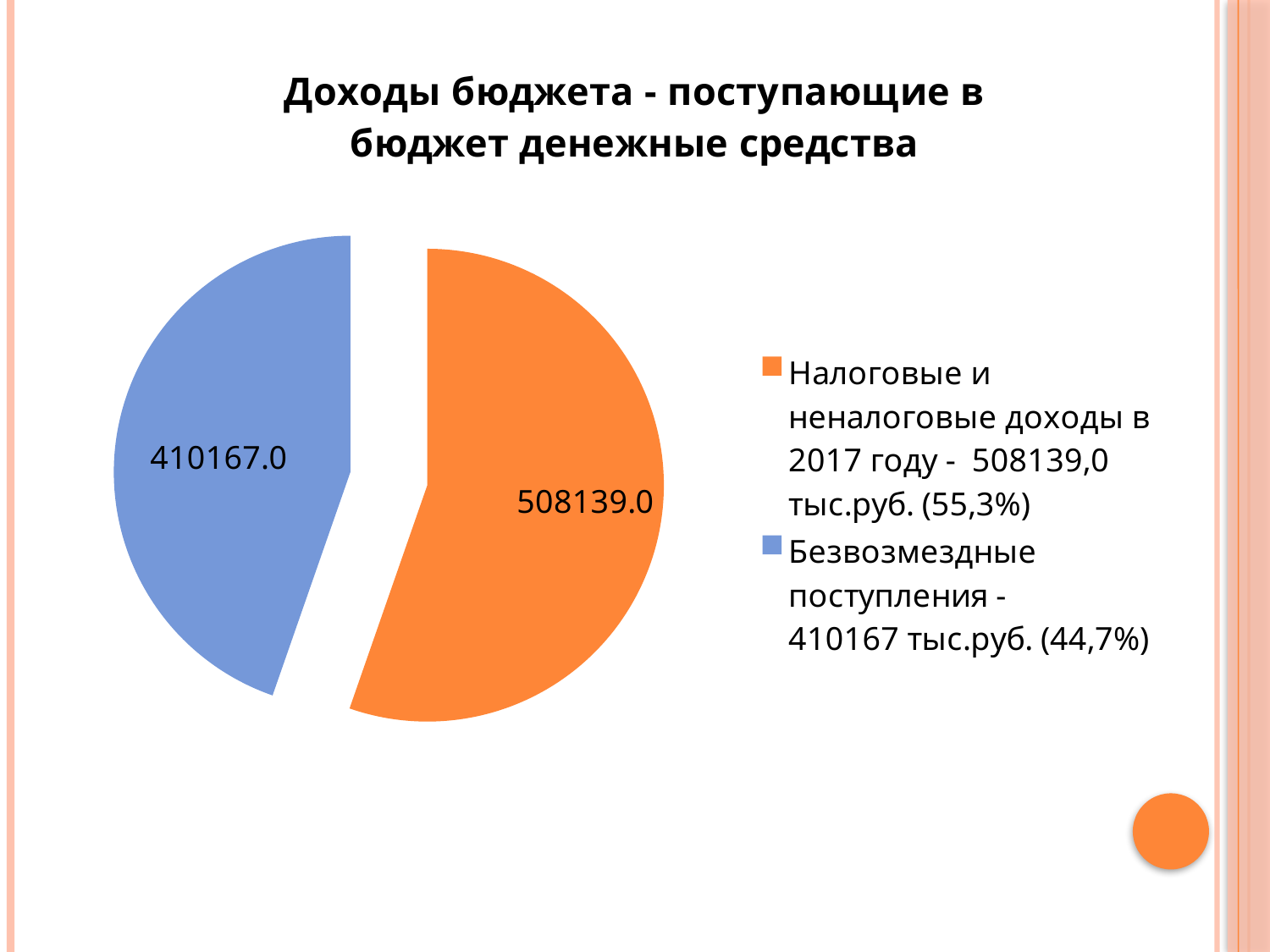
What colour is the slice for Безвозмездные поступления? blue Which category has the largest slice of the pie? Налоговые и неналоговые доходы Which category has the smallest slice of the pie? Безвозмездные поступления What kind of chart is shown on the slide? pie chart What is the title of the chart on the slide? Доходы бюджета - поступающие в бюджет денежные средства What share of the pie does the Налоговые и неналоговые доходы slice represent, as stated in the legend? 55,3% What is the value of the slice for Безвозмездные поступления? 410167.0 What share of the pie does the Безвозмездные поступления slice represent, as stated in the legend? 44,7% Which is larger: the slice for Налоговые и неналоговые доходы or the slice for Безвозмездные поступления? Налоговые и неналоговые доходы What is the difference between the values for Налоговые и неналоговые доходы and Безвозмездные поступления? 97972 What is the value of the slice for Налоговые и неналоговые доходы? 508139.0 How many slices does the pie chart have? 2